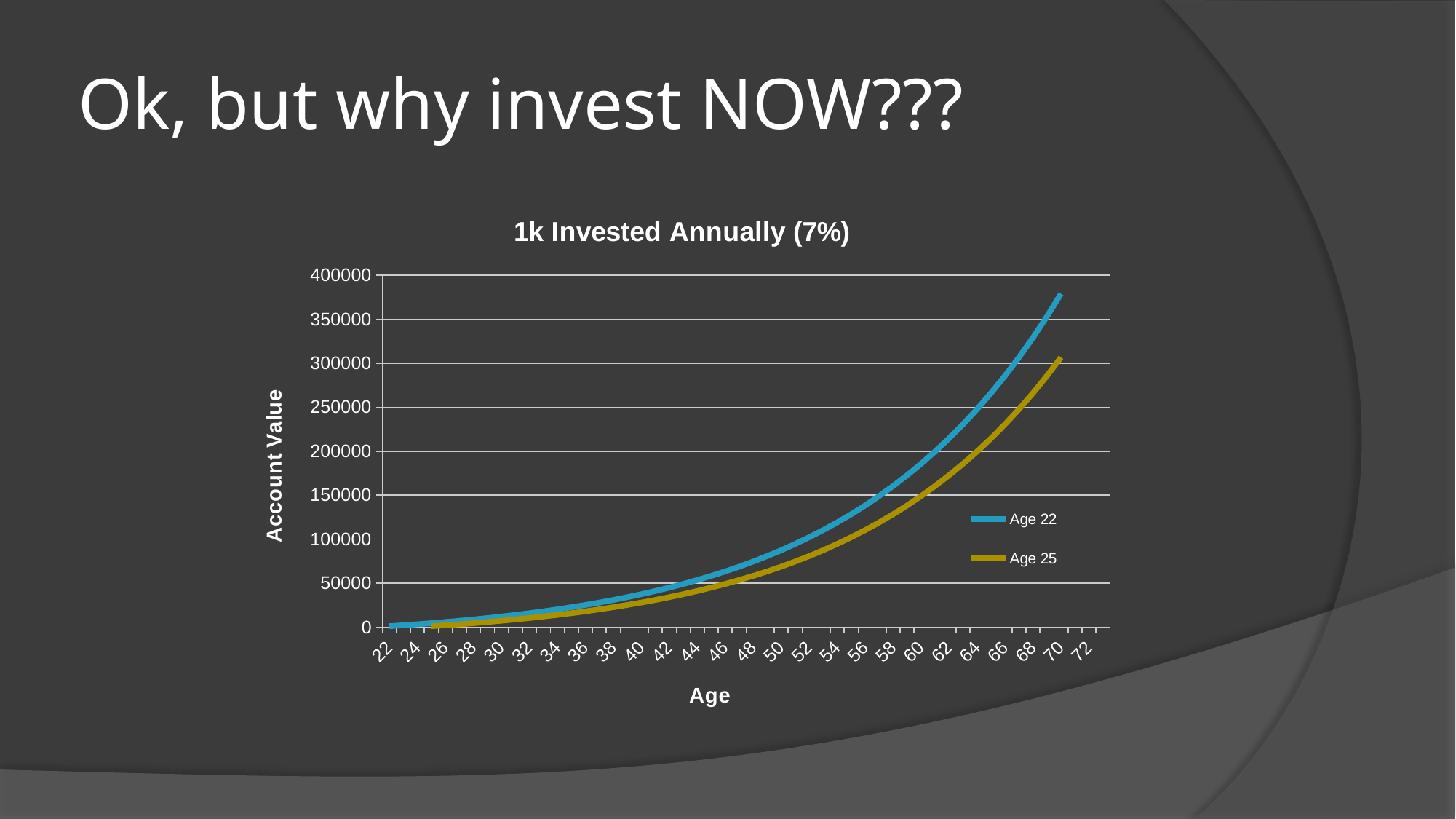
Is the value for the Age 22 series at age 50 greater or less than 100000? less How many series does the legend list? 2 Is the value for the Age 22 series at age 40 greater or less than 50000? less What kind of chart is shown on the slide? line chart What is the title of the chart? 1k Invested Annually (7%) Is the value for the Age 25 series at age 50 greater or less than 100000? less Do the values for the Age 25 series rise or fall as age increases? rise What is the label on the vertical axis of the chart? Account Value At age 70, which series has the higher account value, Age 22 or Age 25? Age 22 Do the values for the Age 22 series rise or fall as age increases? rise